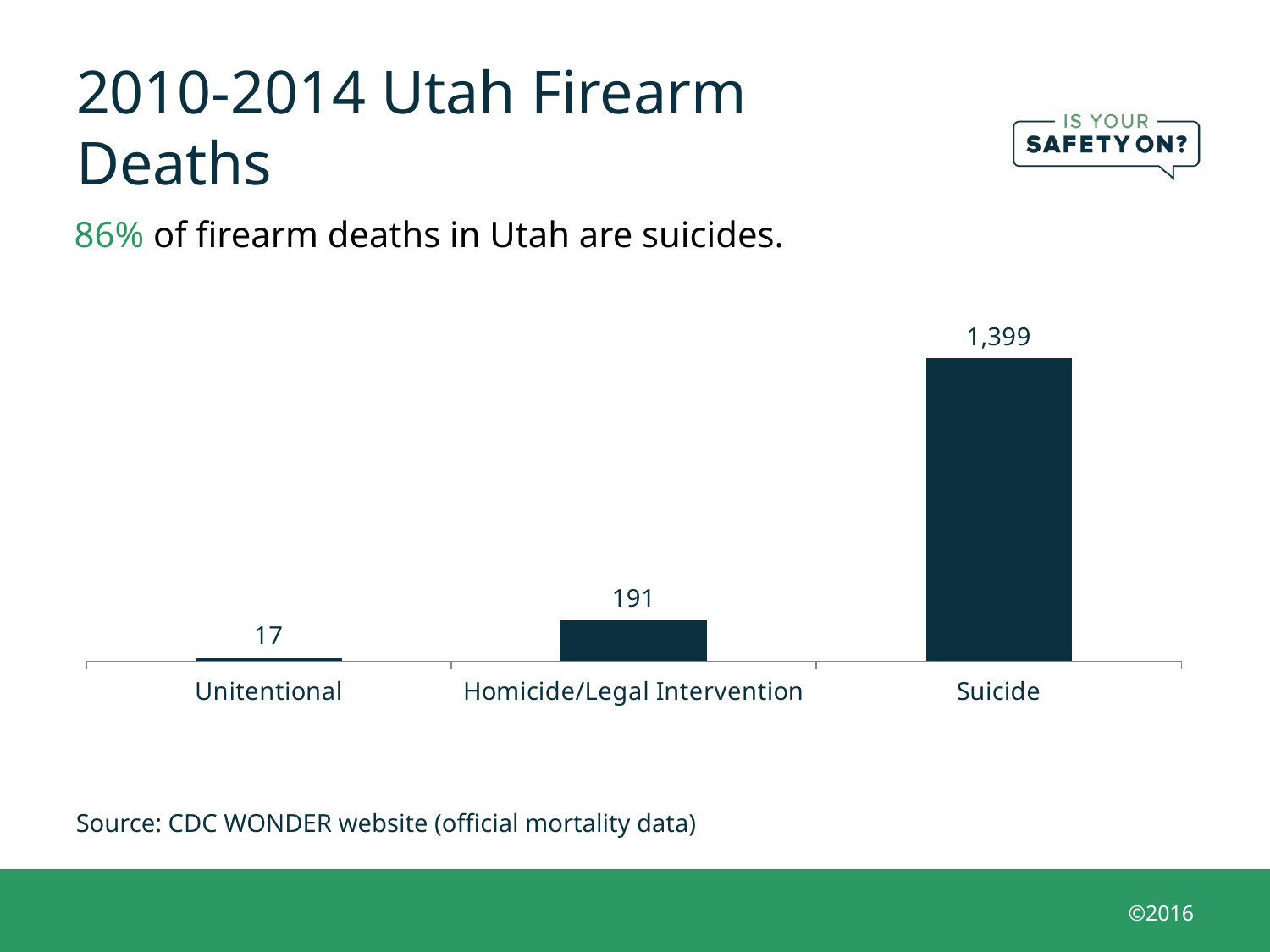
What is the value for Homicide/Legal Intervention? 191 What is the value for Unitentional? 17 Which category has the highest value? Suicide How many categories are shown on the x axis? 3 What is the difference between the Homicide/Legal Intervention and Unitentional values? 174 What is the value for Suicide? 1,399 Which category has the lowest value? Unitentional What kind of chart is shown on the slide? bar chart What is the difference between the Suicide and Homicide/Legal Intervention values? 1,208 Do the values rise or fall from left to right along the x axis? rise What is the source cited for the chart data? CDC WONDER website (official mortality data) Which is larger, the value for Homicide/Legal Intervention or the value for Unitentional? Homicide/Legal Intervention